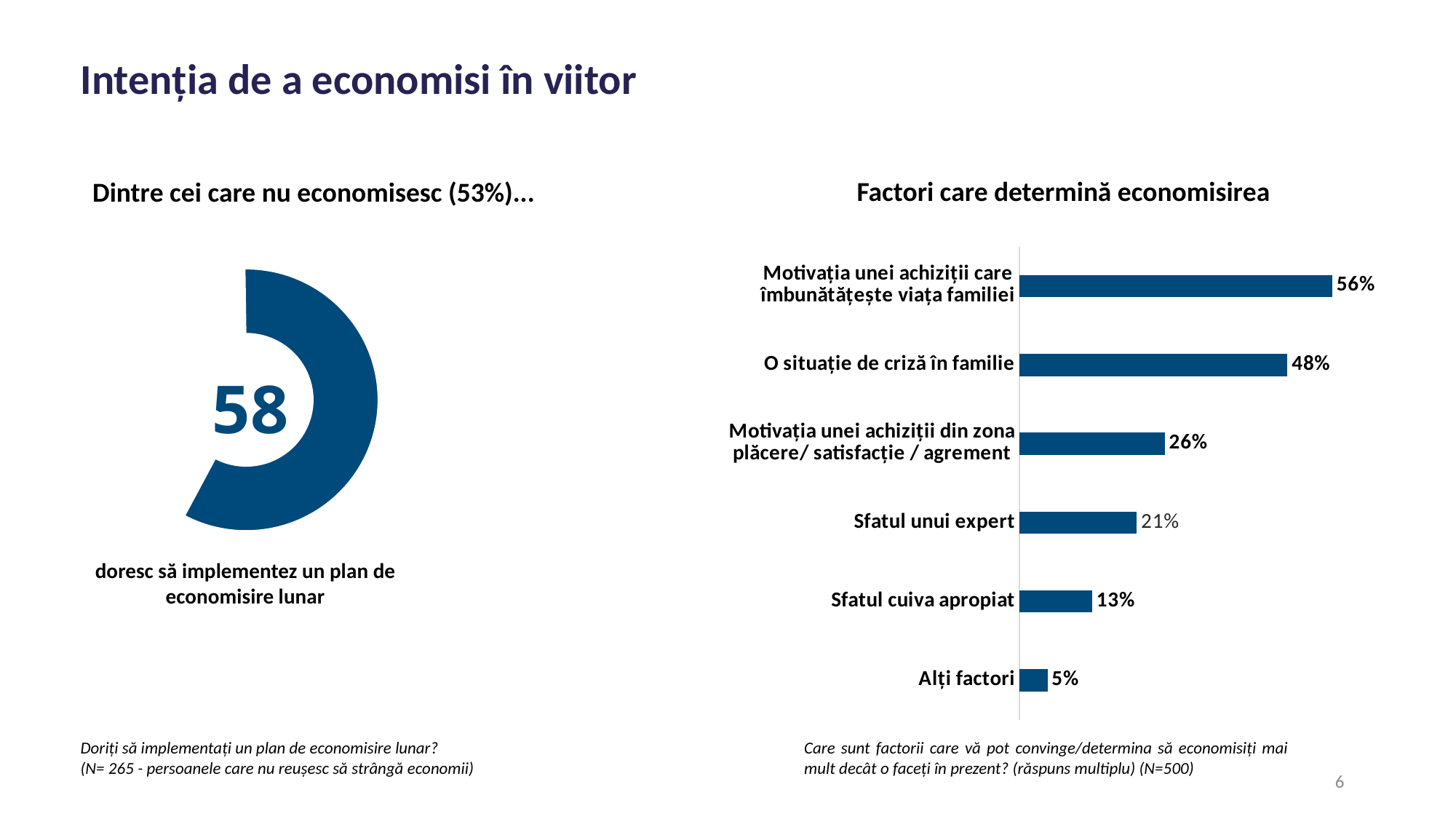
How many factors are listed in the chart 'Factori care determină economisirea'? 6 In the chart 'Factori care determină economisirea', what is the difference between 'Motivația unei achiziții din zona plăcere/ satisfacție / agrement' and 'Sfatul cuiva apropiat'? 13% What kind of chart is 'Factori care determină economisirea'? Bar chart In the chart 'Factori care determină economisirea', which factor has the highest value? Motivația unei achiziții care îmbunătățește viața familiei In the chart 'Factori care determină economisirea', what is the value for 'O situație de criză în familie'? 48% In the chart 'Factori care determină economisirea', which is larger: 'Sfatul unui expert' or 'Sfatul cuiva apropiat'? Sfatul unui expert In the chart 'Factori care determină economisirea', what is the value for 'Alți factori'? 5% In the chart 'Factori care determină economisirea', what is the difference between 'Motivația unei achiziții care îmbunătățește viața familiei' and 'O situație de criză în familie'? 8% In the chart 'Factori care determină economisirea', what is the value for 'Sfatul unui expert'? 21% In the chart 'Factori care determină economisirea', which factor has the lowest value? Alți factori What is the title of the chart on the right of the slide? Factori care determină economisirea What number is shown in the centre of the donut chart on the left of the slide? 58